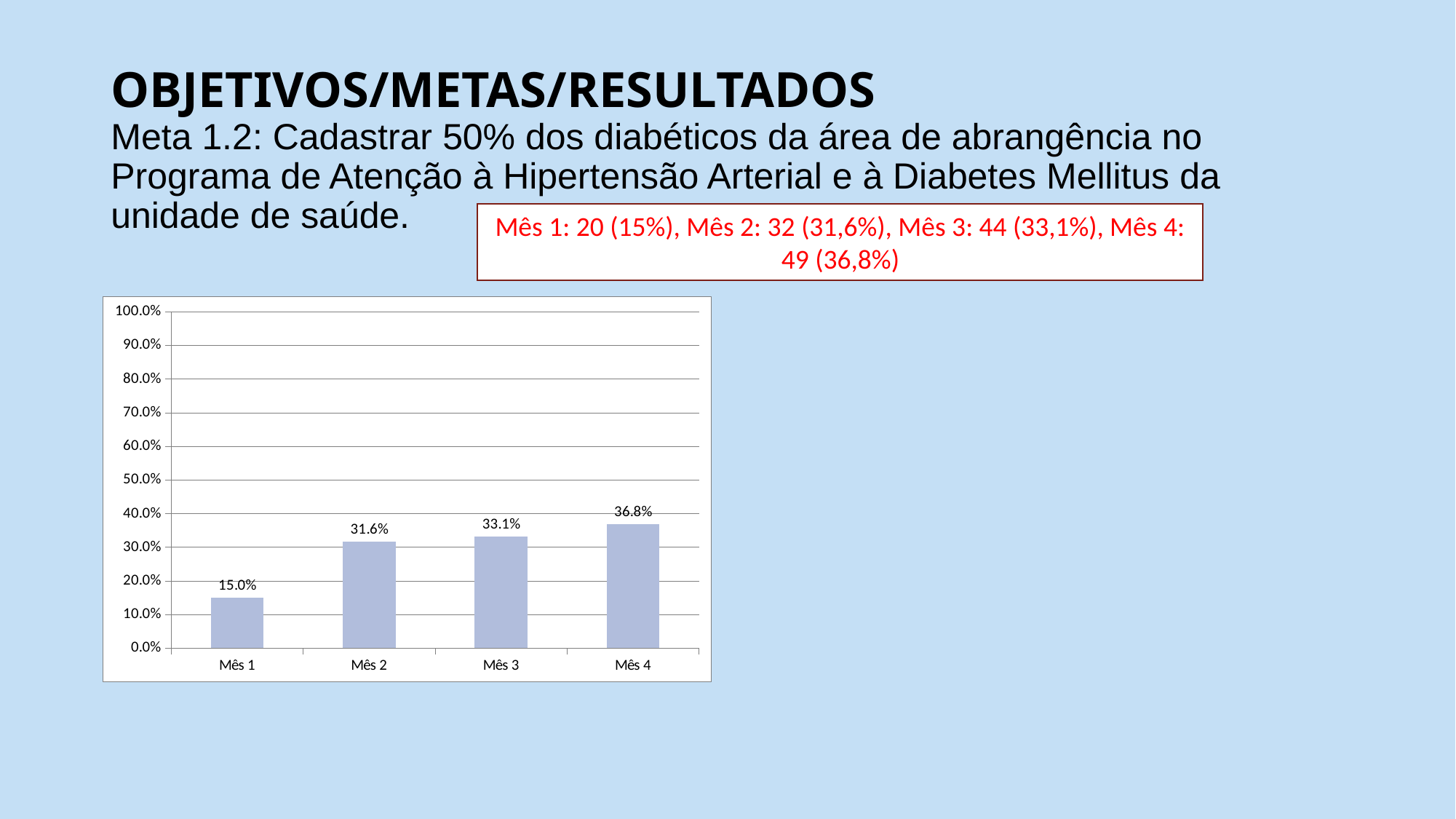
What is the value for Mês 1? 15.0% What kind of chart is shown on the slide? bar chart Which month has the highest value? Mês 4 Is the value for Mês 4 greater or less than 50.0%? less How many months are shown on the x axis? 4 What is the value for Mês 3? 33.1% What is the value for Mês 4? 36.8% Which month has the lowest value? Mês 1 Which is larger, the value for Mês 2 or the value for Mês 4? Mês 4 What is the difference between the values for Mês 2 and Mês 1? 16.6% What is the difference between the values for Mês 4 and Mês 1? 21.8% What is the value for Mês 2? 31.6%